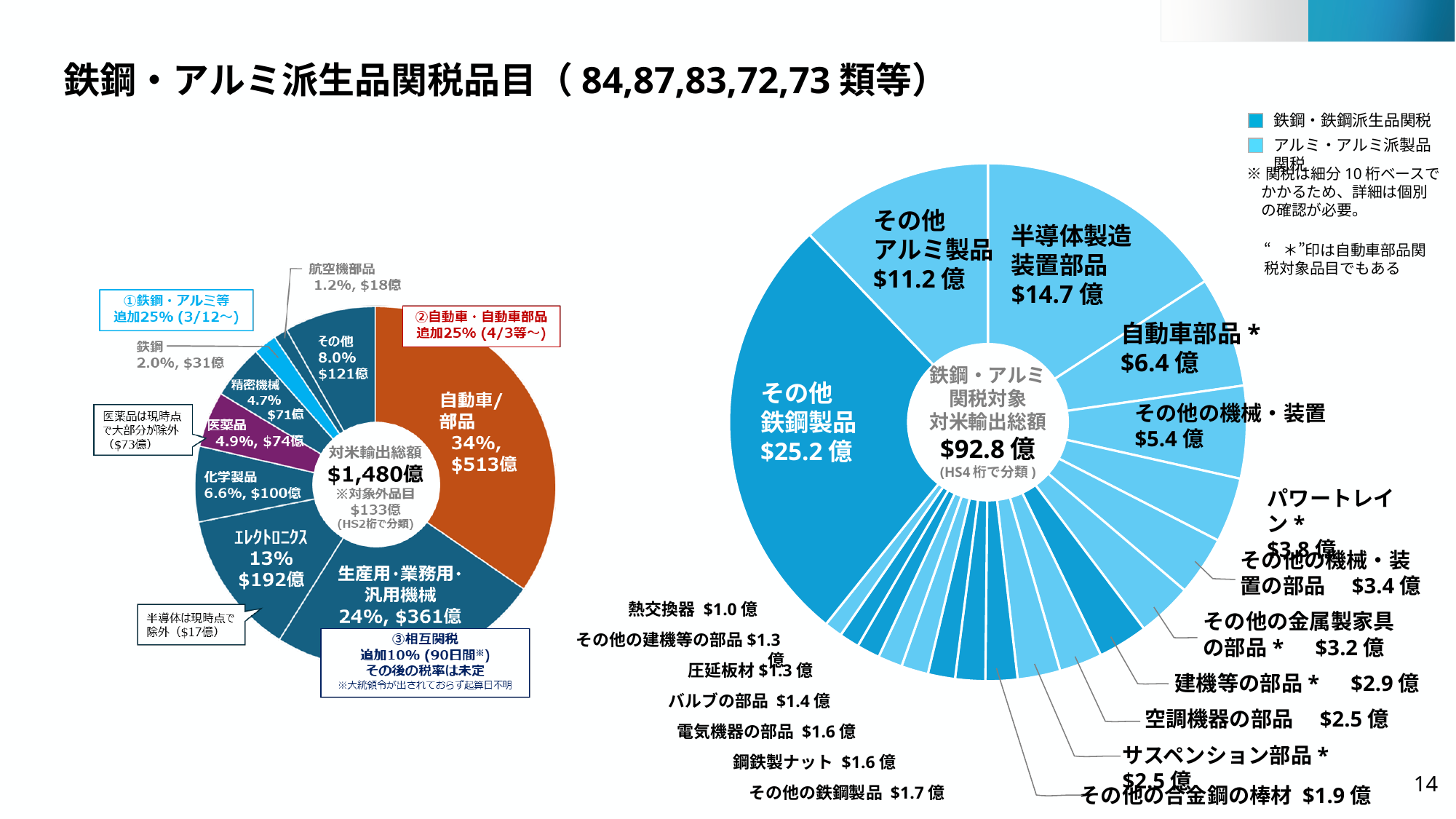
In the right pie chart, what is the total 鉄鋼・アルミ関税対象対米輸出総額 shown in the center? $92.8 億 In the right pie chart, what is the value for 半導体製造装置部品? $14.7 億 How many entries does the legend of the right pie chart list? 2 In the right pie chart, which category has the largest value? その他鉄鋼製品 In the right pie chart, which category has the smallest value? 熱交換器 In the left pie chart, what is the difference in value between 生産用・業務用・汎用機械 and 化学製品? $261億 In the left pie chart, what is the value for 自動車/部品? 34%, $513億 What type of charts are shown on the slide? Pie charts In the left pie chart, which category has the smallest share? 航空機部品 In the left pie chart, what is the value for エレクトロニクス? 13%, $192億 In the left pie chart, what is the total 対米輸出総額 shown in the center? $1,480億 In the right pie chart, which is larger: 自動車部品 * or その他の機械・装置? 自動車部品 *